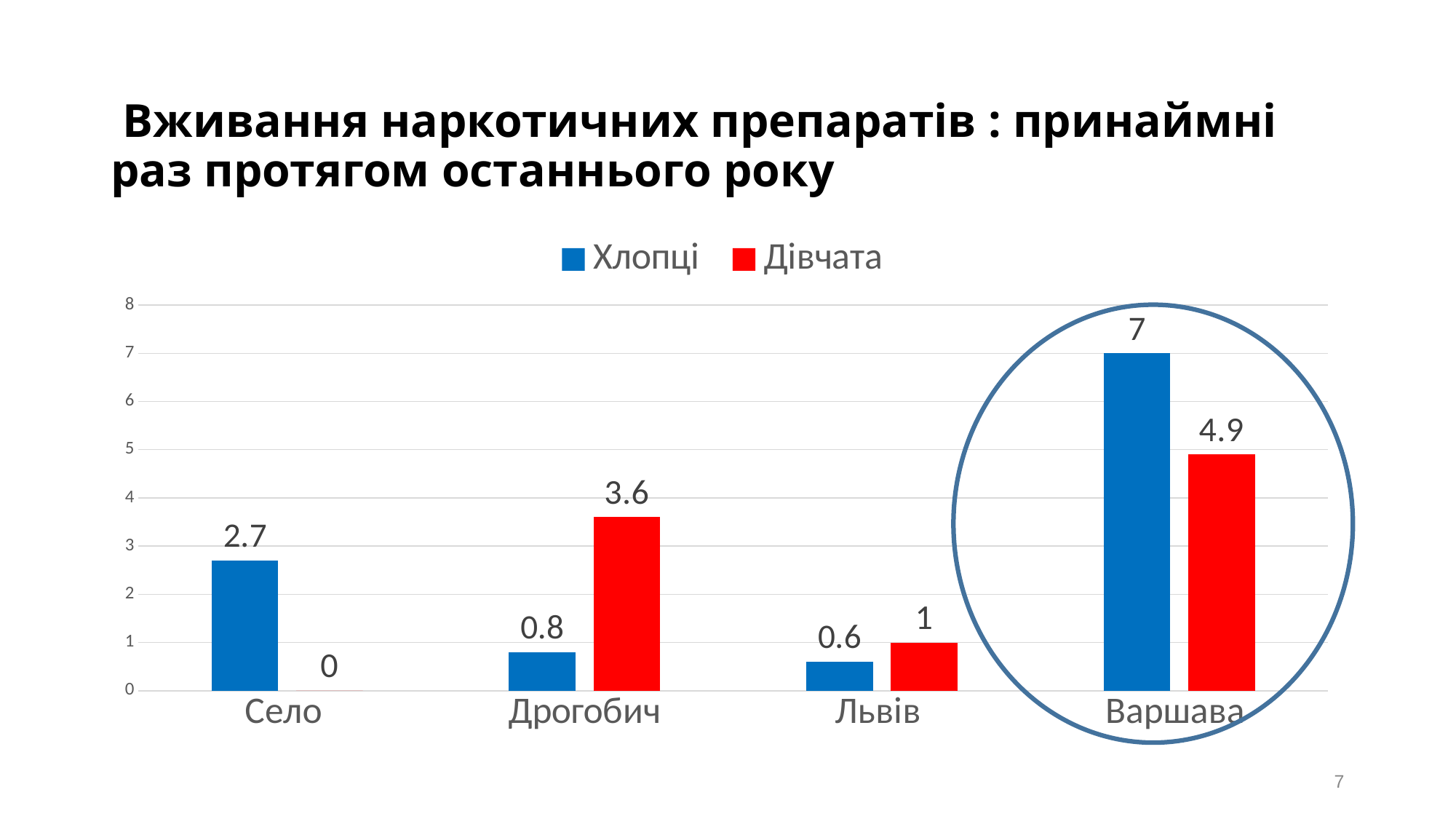
Which category has the lowest value for Дівчата? Село What is the difference between the Хлопці and Дівчата values in Варшава? 2.1 How many categories are shown on the x axis? 4 How many series does the legend list? 2 Which category is highlighted with a circle on the chart? Варшава What is the value for Дівчата in Львів? 1 Which is larger in Дрогобич: the value for Хлопці or for Дівчата? Дівчата What is the value for Хлопці in Варшава? 7 What kind of chart is shown on the slide? Bar chart Which category has the highest value for Хлопці? Варшава What is the value for Дівчата in Дрогобич? 3.6 What is the value for Хлопці in Село? 2.7